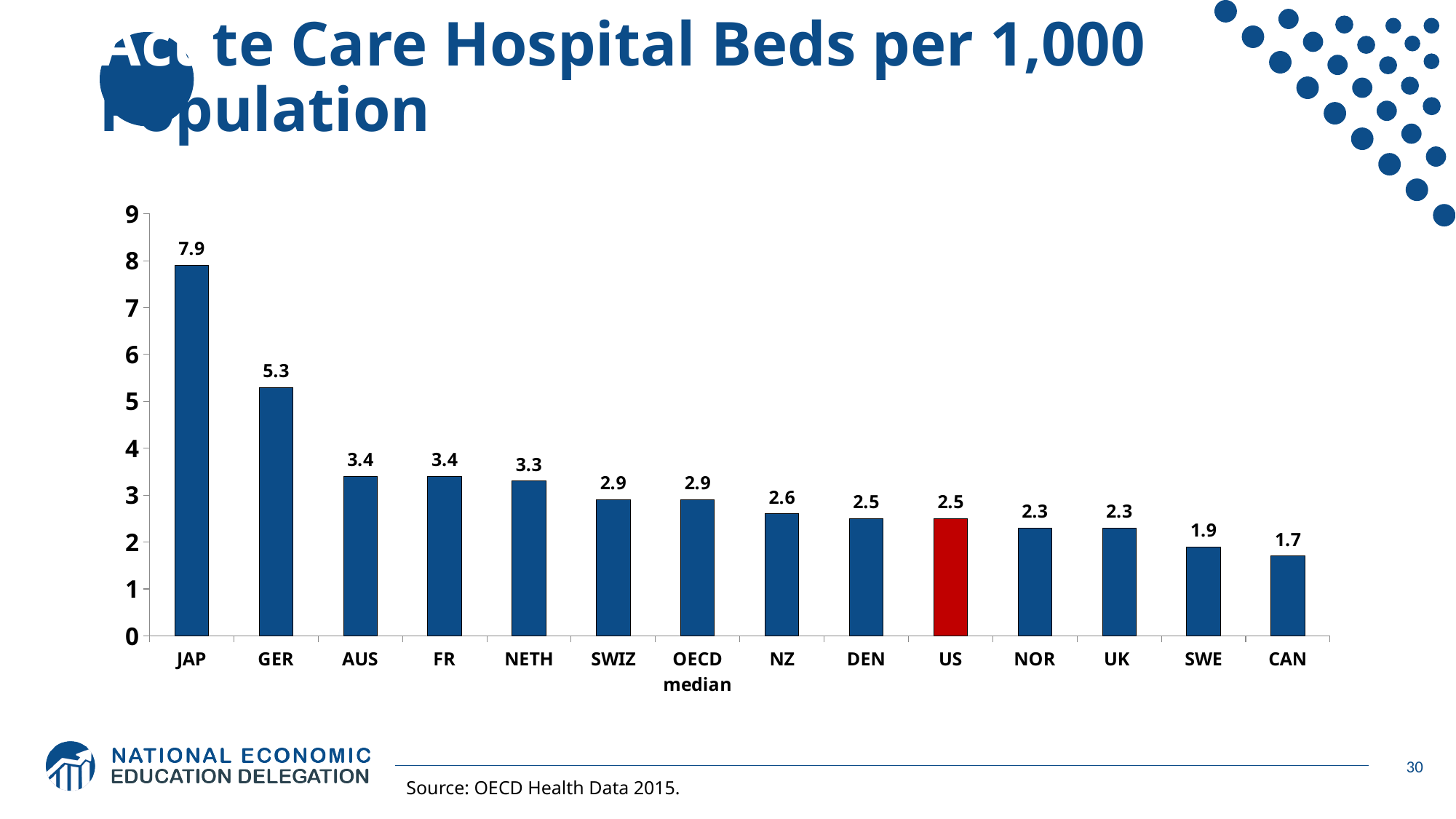
Which bar is coloured red rather than blue? US What is the difference between the values for JAP and GER? 2.6 What is the value for the US? 2.5 Which category has the highest value? JAP How many categories are shown on the x axis? 14 What kind of chart is shown on the slide? bar chart What is the difference between the OECD median and the US value? 0.4 What is the value for JAP? 7.9 Is the value for NETH greater or less than 3? greater Which is larger, the value for GER or the value for AUS? GER What is the value for the OECD median? 2.9 Which category has the lowest value? CAN